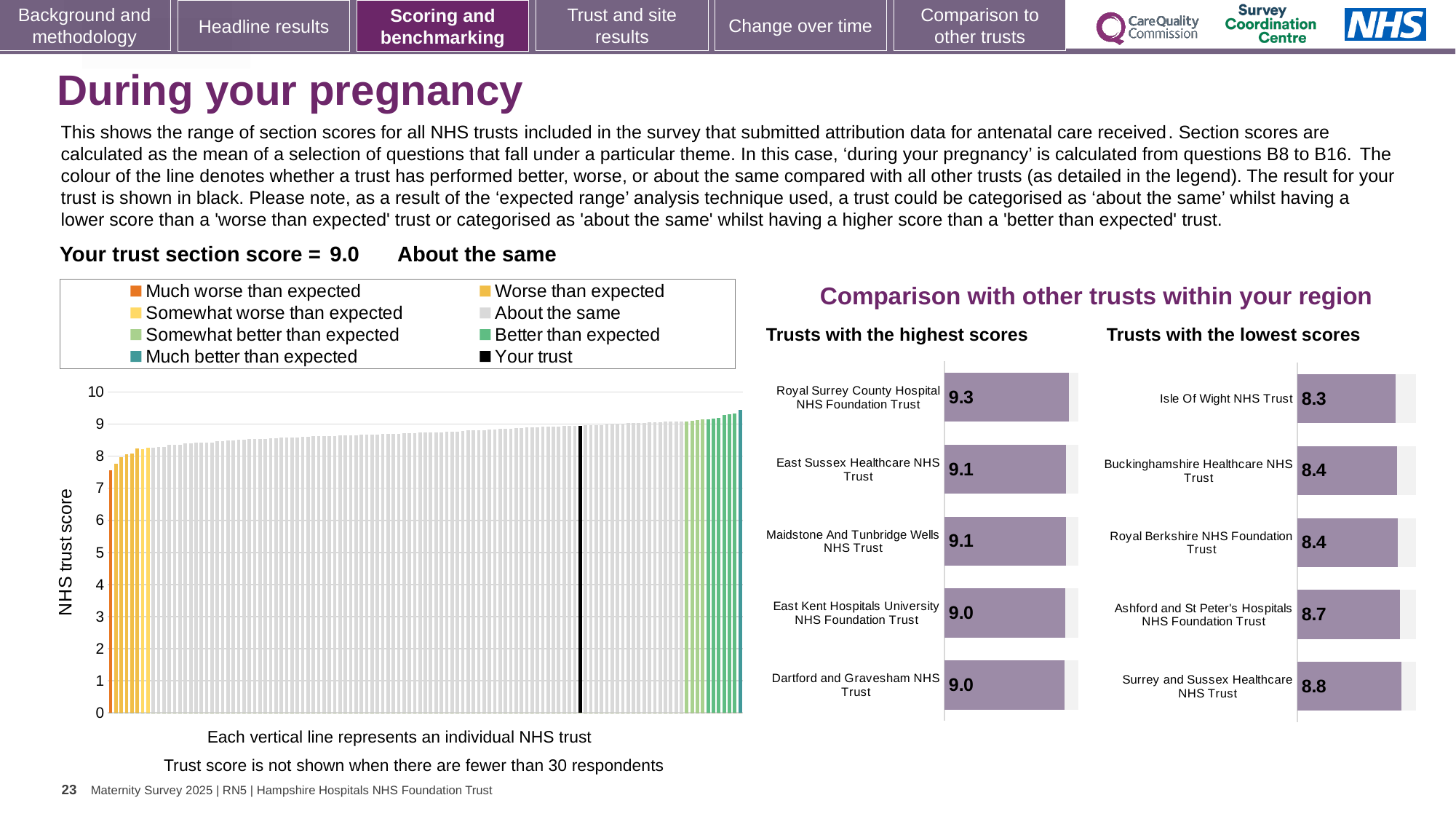
In the main 'NHS trust score' chart, do the values rise or fall from left to right? rise How many trusts are shown in the 'Trusts with the highest scores' chart? 5 In the 'Trusts with the highest scores' chart, what is the difference between the scores of Royal Surrey County Hospital NHS Foundation Trust and Dartford and Gravesham NHS Trust? 0.3 In the 'Trusts with the lowest scores' chart, which has the higher score: Ashford and St Peter's Hospitals NHS Foundation Trust or Buckinghamshire Healthcare NHS Trust? Ashford and St Peter's Hospitals NHS Foundation Trust In the 'Trusts with the lowest scores' chart, what is the score for Isle Of Wight NHS Trust? 8.3 In the 'Trusts with the lowest scores' chart, what is the difference between the scores of Surrey and Sussex Healthcare NHS Trust and Isle Of Wight NHS Trust? 0.5 In the 'Trusts with the lowest scores' chart, which trust has the lowest score? Isle Of Wight NHS Trust In the 'Trusts with the highest scores' chart, which trust has the highest score? Royal Surrey County Hospital NHS Foundation Trust In the 'Trusts with the highest scores' chart, what is the score for Royal Surrey County Hospital NHS Foundation Trust? 9.3 How many entries does the legend of the main 'NHS trust score' chart list? 8 In the main 'NHS trust score' chart, is the value of the black 'Your trust' bar greater or less than 8? greater What kind of chart is the main chart on the left showing NHS trust scores? bar chart